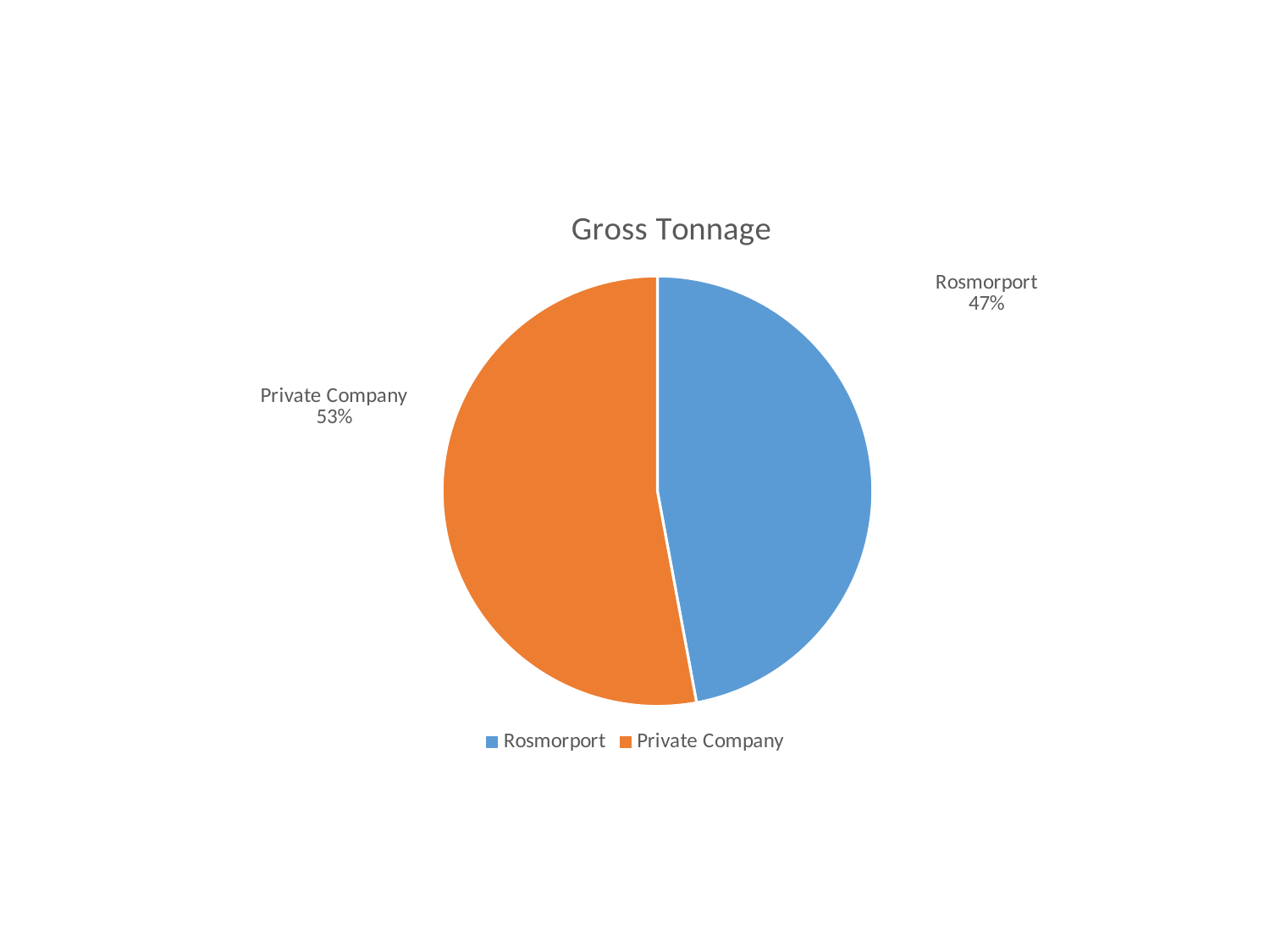
How many entries does the legend list? 2 What share of Gross Tonnage does Private Company hold? 53% How many slices does the pie chart have? 2 What is the difference in percentage points between the Private Company and Rosmorport shares? 6 percentage points What colour is the Rosmorport slice? Blue What kind of chart is shown on the slide? Pie chart What is the title of the chart? Gross Tonnage Which category has the largest share of Gross Tonnage? Private Company What share of Gross Tonnage does Rosmorport hold? 47% Which is larger, the Rosmorport share or the Private Company share? Private Company Which category has the smallest share of Gross Tonnage? Rosmorport